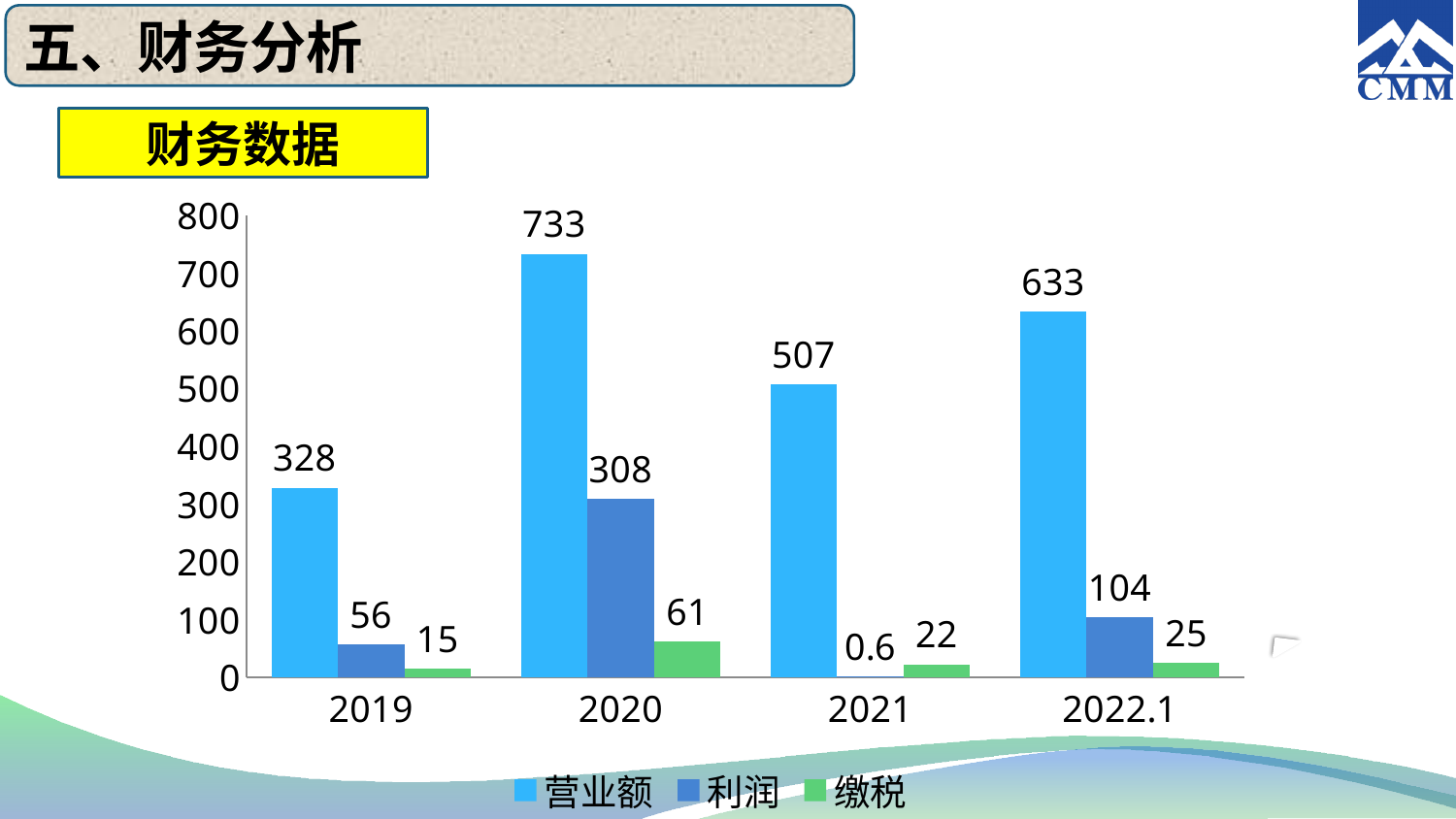
How many categories are shown on the x axis? 4 What is the 缴税 value for 2022.1? 25 Which is larger, the 缴税 value for 2020 or for 2021? 2020 What is the 营业额 value for 2020? 733 What is the 利润 value for 2021? 0.6 Is the 营业额 value for 2021 greater or less than 400? greater How many series does the legend list? 3 What is the title shown in the yellow box above the chart? 财务数据 Which year has the highest 营业额? 2020 What is the difference between the 营业额 values for 2020 and 2019? 405 What kind of chart is shown on the slide? bar chart Which year has the lowest 利润? 2021